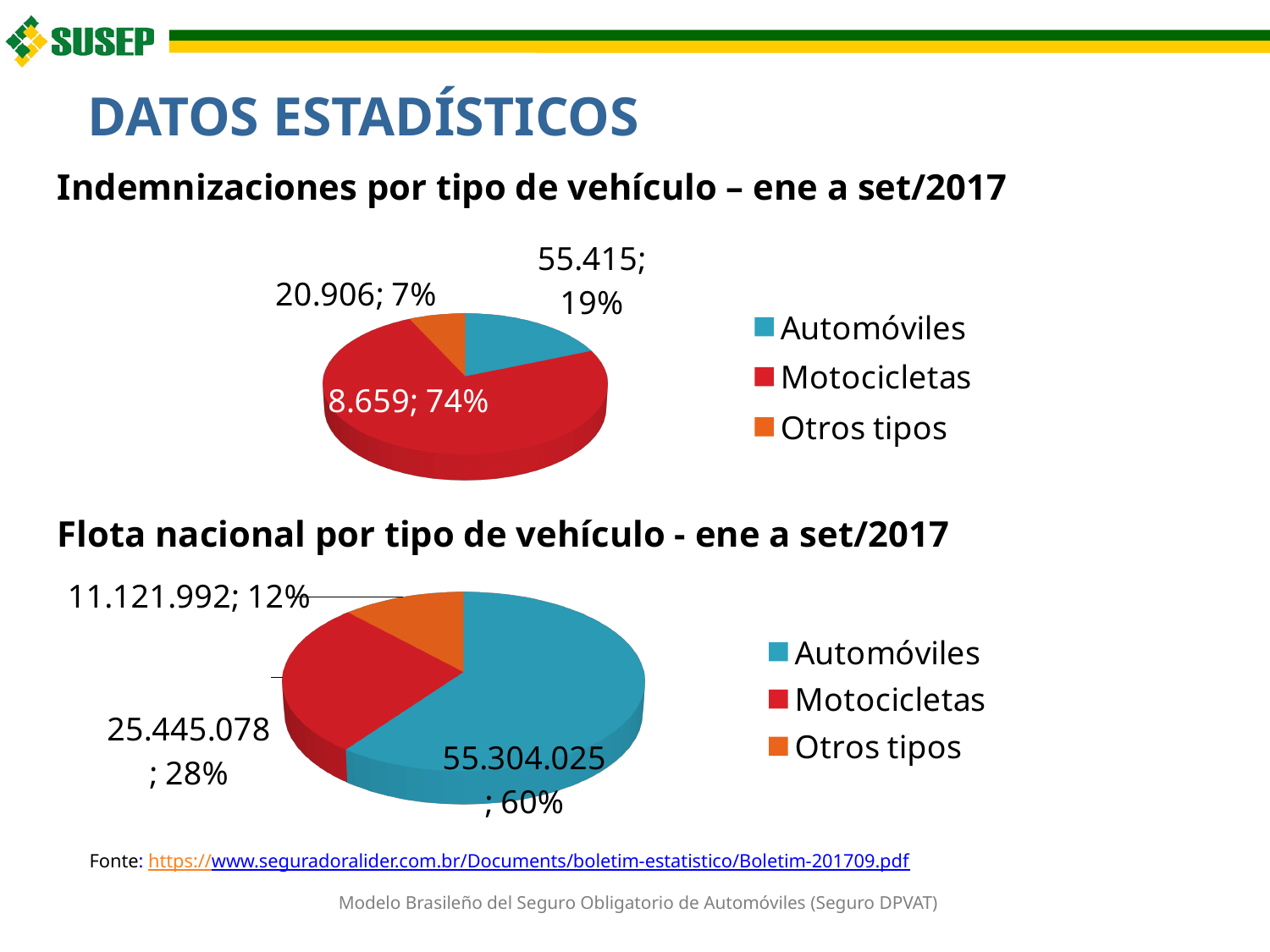
In the 'Flota nacional por tipo de vehículo' chart, which category has the largest slice? Automóviles In the 'Flota nacional por tipo de vehículo' chart, what value is shown for Otros tipos? 11.121.992 In the 'Flota nacional por tipo de vehículo' chart, what share of the pie does Automóviles represent? 60% In the 'Flota nacional por tipo de vehículo' chart, what value is shown for Motocicletas? 25.445.078 In the 'Indemnizaciones por tipo de vehículo' chart, which category has the smallest slice? Otros tipos In the 'Indemnizaciones por tipo de vehículo' chart, what share of the pie does Otros tipos represent? 7% In the 'Flota nacional por tipo de vehículo' chart, which is larger, Motocicletas or Otros tipos? Motocicletas In the 'Indemnizaciones por tipo de vehículo' chart, what is the difference between the values for Automóviles and Otros tipos? 34.509 In the 'Indemnizaciones por tipo de vehículo' chart, what share of the pie does Motocicletas represent? 74% What type of chart is used for 'Flota nacional por tipo de vehículo'? Pie chart In the 'Indemnizaciones por tipo de vehículo' chart, which category has the largest slice? Motocicletas In the 'Indemnizaciones por tipo de vehículo' chart, what value is shown for Automóviles? 55.415